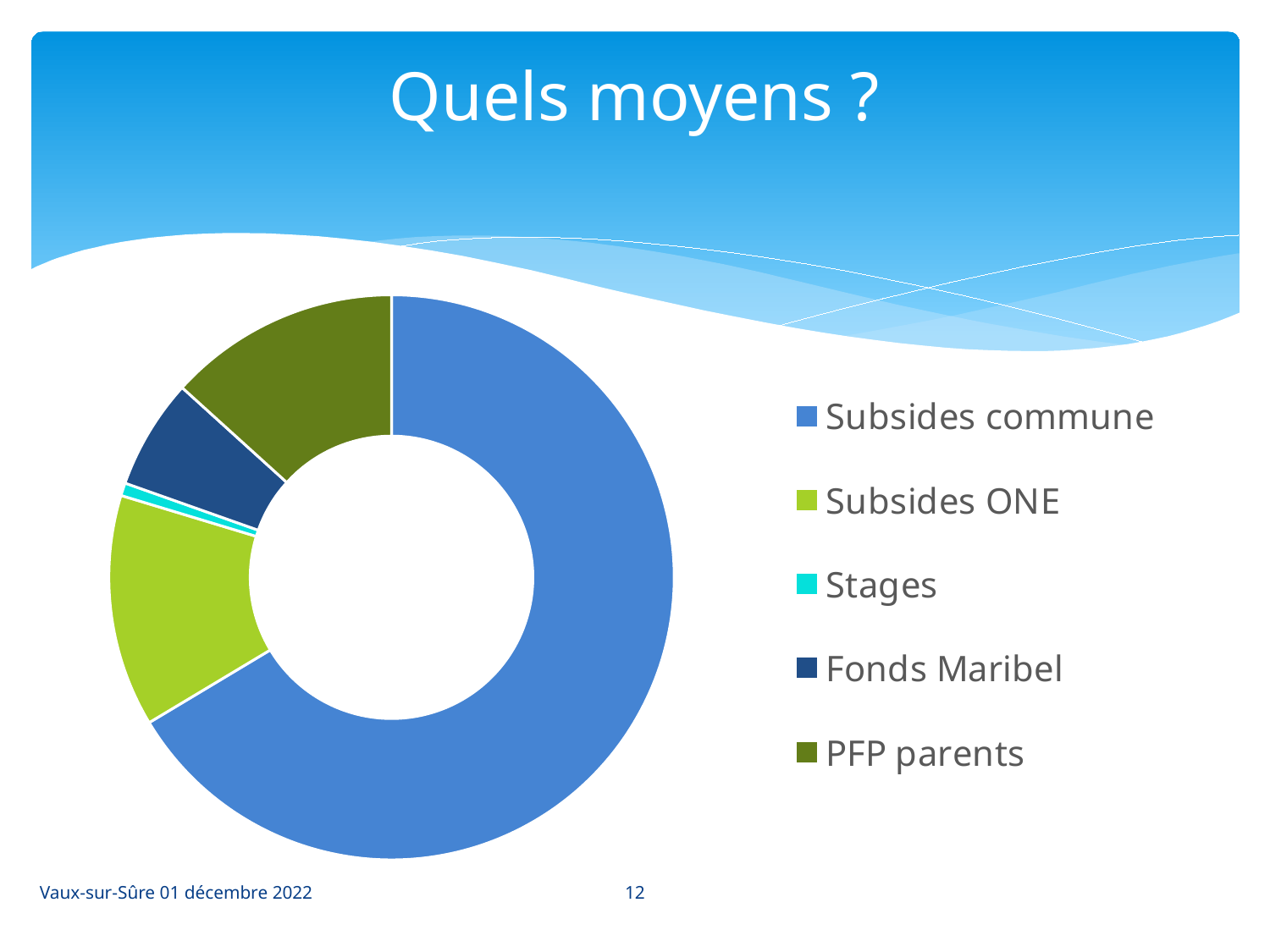
Which slice is larger, Subsides commune or PFP parents? Subsides commune Does the Subsides commune slice take up more or less than half of the chart? More Which slice is larger, Subsides ONE or Fonds Maribel? Subsides ONE What kind of chart is shown on the slide? Doughnut (pie) chart What colour is used for the Stages category in the chart? Cyan (light blue) What is the title of the slide containing the chart? Quels moyens ? Which category has the smallest slice of the chart? Stages Which category has the largest slice of the chart? Subsides commune How many categories does the chart's legend list? 5